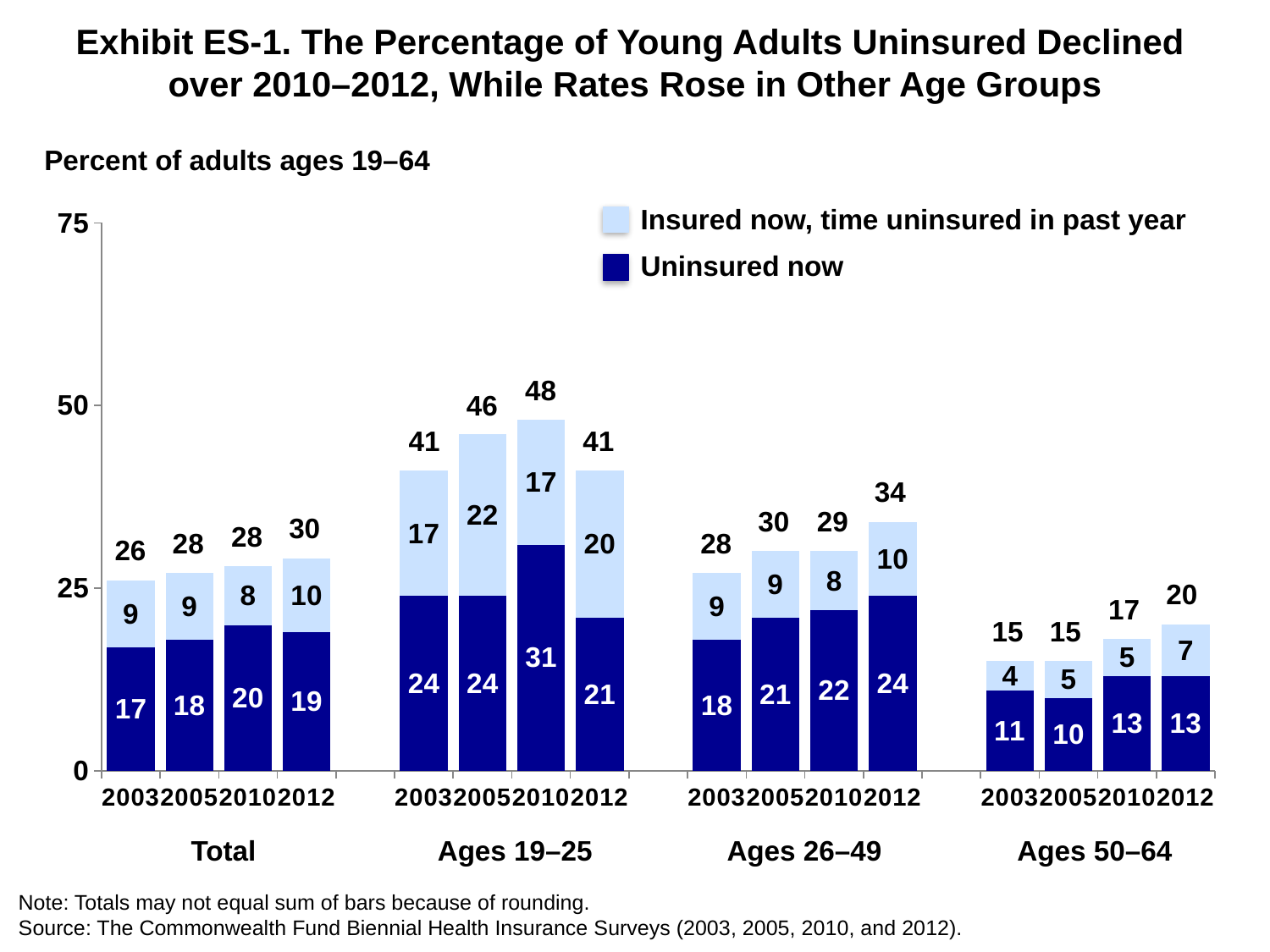
Which bar has the lowest 'Uninsured now' value? Ages 50–64, 2005 (10) Which is larger in 2012: the total for Ages 26–49 or the total for the Total group? Ages 26–49 What is the total printed above the 2012 bar for Ages 26–49? 34 Do the totals for Ages 50–64 rise or fall from 2003 to 2012? rise What is the 'Insured now, time uninsured in past year' value for Ages 50–64 in 2012? 7 Is the total for Ages 19–25 in 2005 greater or less than 50? less What kind of chart is shown on the slide? Stacked bar chart Which bar has the highest total across all groups and years? Ages 19–25, 2010 (48) What is the difference between the totals for Ages 19–25 in 2010 and 2012? 7 How many stacked bars are plotted in the chart? 16 What is the 'Uninsured now' value for Ages 19–25 in 2010? 31 How many series does the legend list? 2